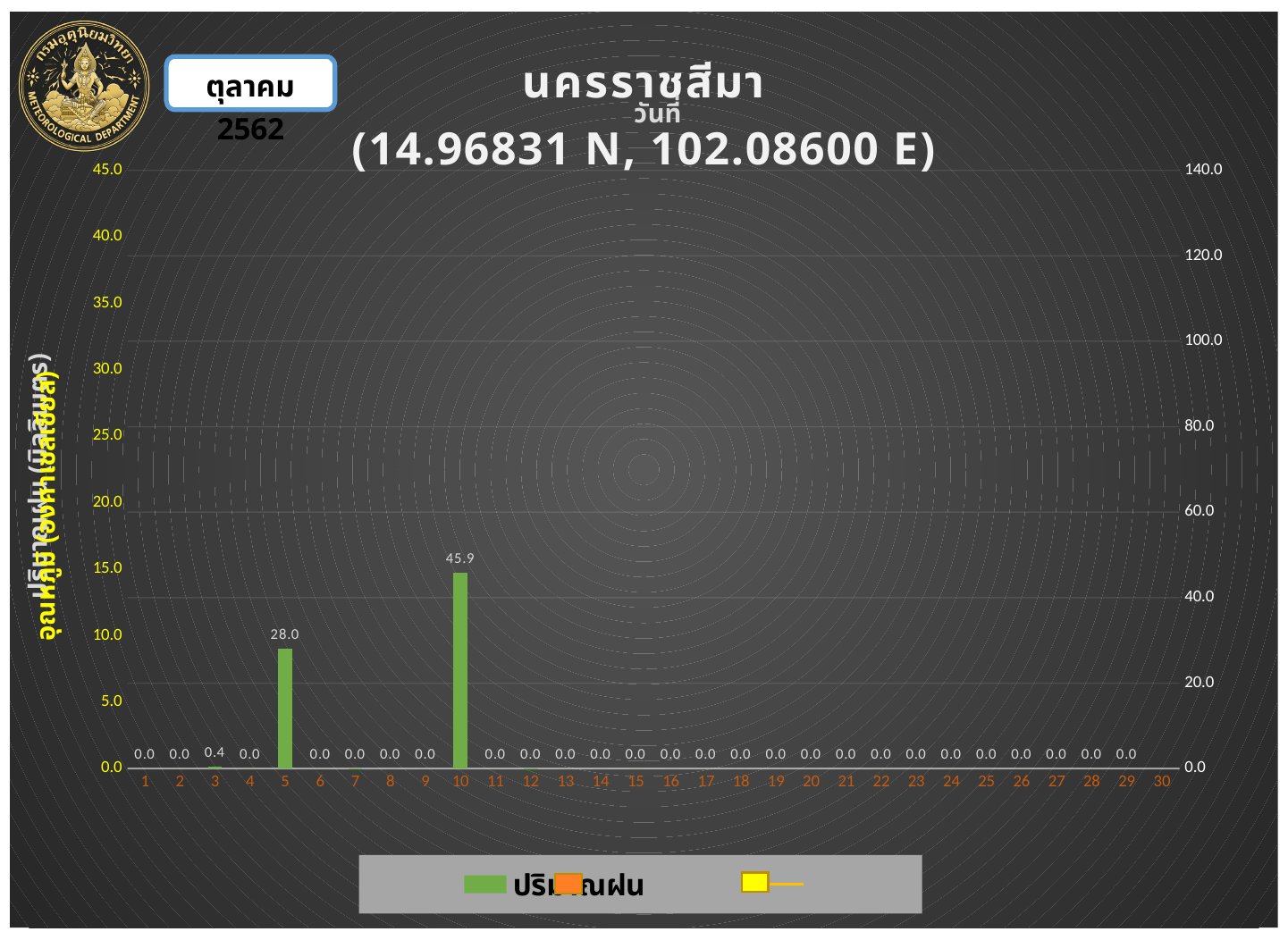
What kind of chart is shown on the slide? bar chart What is the rainfall value shown for day 10? 45.9 What station name is shown in the chart title? นครราชสีมา Which has the larger rainfall value, day 5 or day 10? day 10 What is the rainfall value shown for day 20? 0.0 What is the rainfall value shown for day 5? 28.0 What is the rainfall value shown for day 3? 0.4 Is the value for day 10 greater or less than 40.0 on the right-hand axis? greater What month and year are shown in the box at the top left of the chart? ตุลาคม 2562 What is the difference between the rainfall values for day 10 and day 5? 17.9 Which day has the highest rainfall value? 10 How many days are shown on the x axis? 30